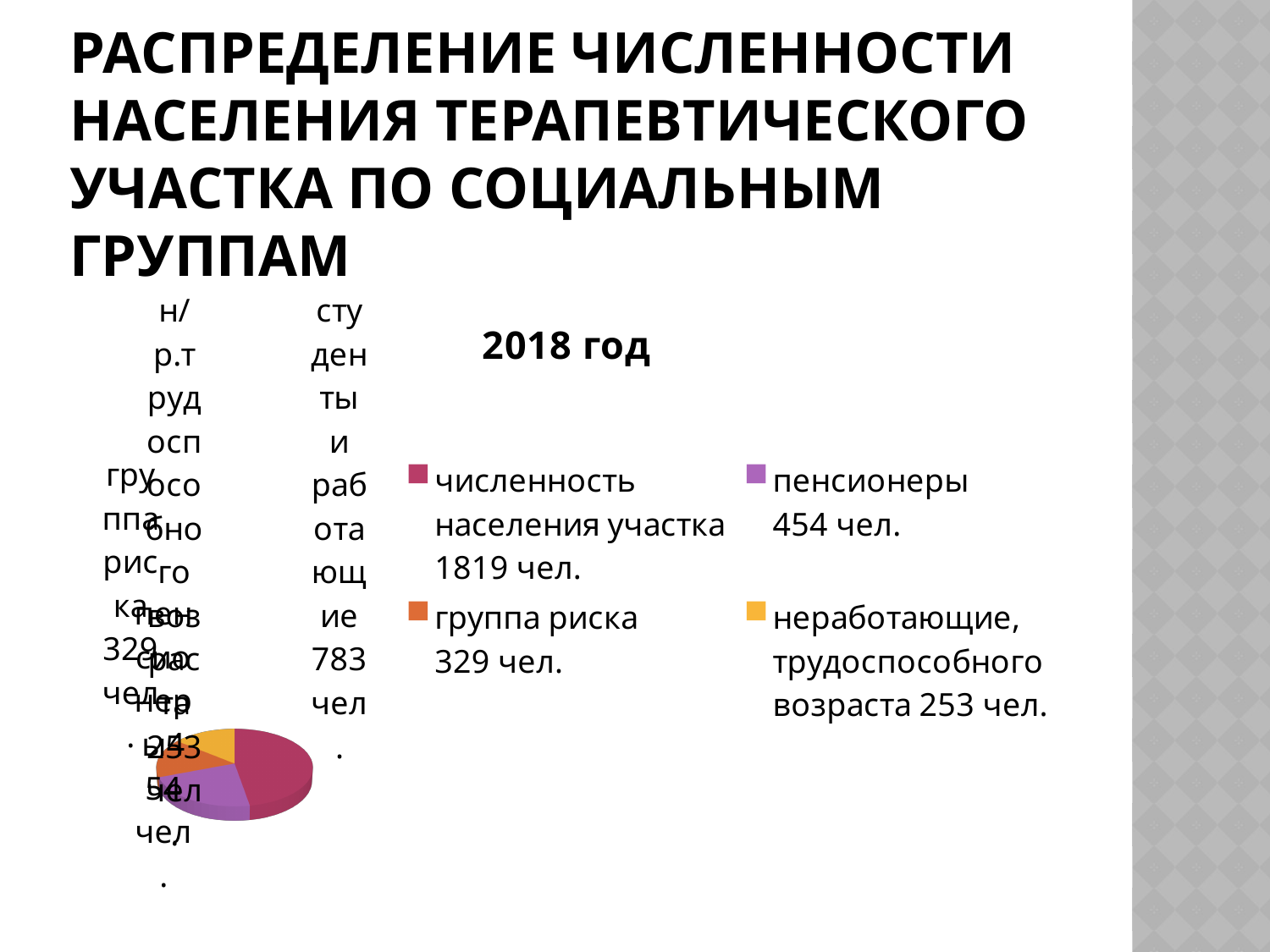
What is the difference between the values for пенсионеры and группа риска? 125 чел. What kind of chart is shown on the slide? pie chart What is the difference between the values for группа риска and неработающие, трудоспособного возраста? 76 чел. According to the legend, what is the value for пенсионеры? 454 чел. Which legend entry has the largest value? численность населения участка How many entries does the chart legend list? 4 Which is larger, the value for пенсионеры or the value for неработающие, трудоспособного возраста? пенсионеры According to the legend, what is the value for неработающие, трудоспособного возраста? 253 чел. Which legend entry has the smallest value? неработающие, трудоспособного возраста According to the legend, what is the value for численность населения участка? 1819 чел. According to the legend, what is the value for группа риска? 329 чел. What is the title of the chart? 2018 год